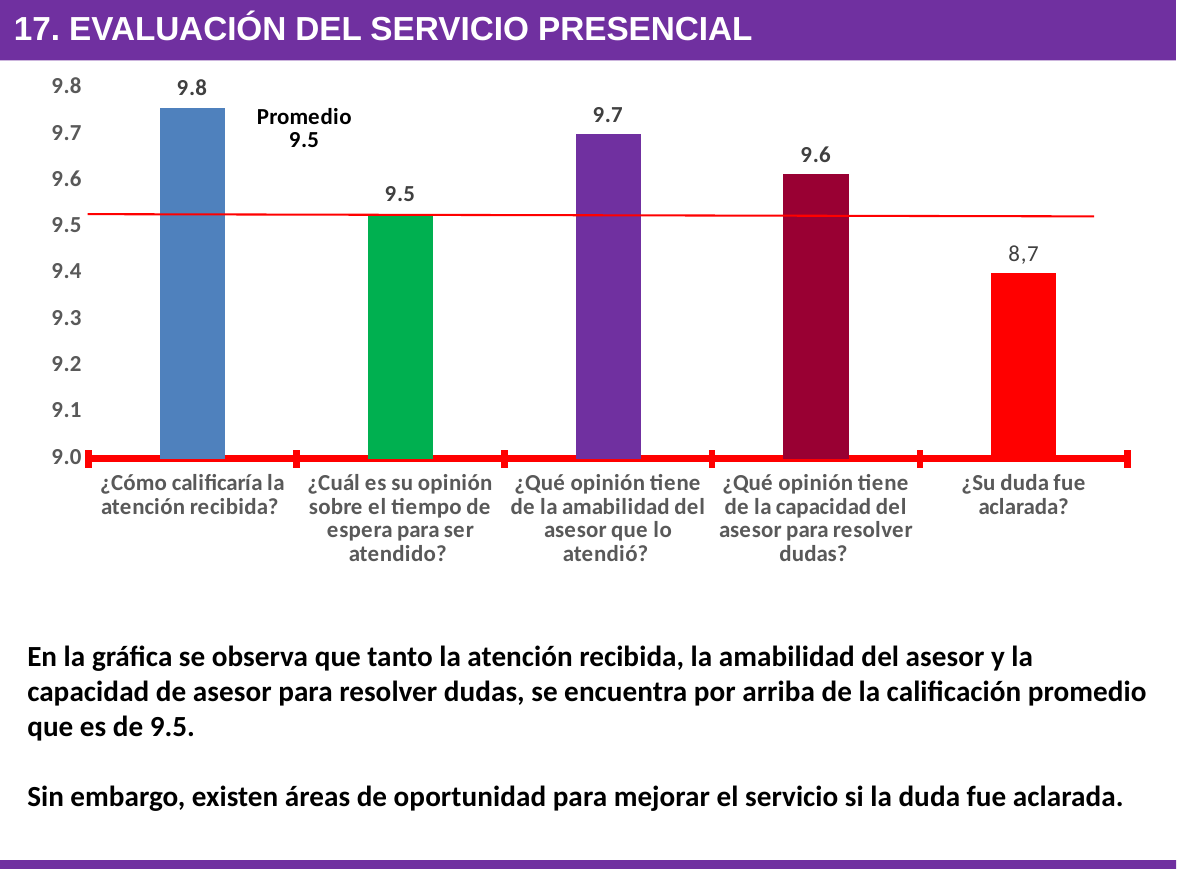
What value is shown for "¿Cuál es su opinión sobre el tiempo de espera para ser atendido?"? 9.5 What value is shown for "¿Qué opinión tiene de la amabilidad del asesor que lo atendió?"? 9.7 Which category has the lowest value? ¿Su duda fue aclarada? What data label is printed above the bar for "¿Su duda fue aclarada?"? 8,7 Which category has the highest value? ¿Cómo calificaría la atención recibida? What value is shown for "¿Cómo calificaría la atención recibida?"? 9.8 What is the difference between the value for "¿Cómo calificaría la atención recibida?" and the value for "¿Cuál es su opinión sobre el tiempo de espera para ser atendido?"? 0.3 What value does the "Promedio" line on the chart represent? 9.5 What value is shown for "¿Qué opinión tiene de la capacidad del asesor para resolver dudas?"? 9.6 How many categories are shown on the x axis? 5 Is the bar for "¿Su duda fue aclarada?" greater or less than 9.5? less Which is larger: the value for "¿Qué opinión tiene de la amabilidad del asesor que lo atendió?" or the value for "¿Qué opinión tiene de la capacidad del asesor para resolver dudas?"? ¿Qué opinión tiene de la amabilidad del asesor que lo atendió?